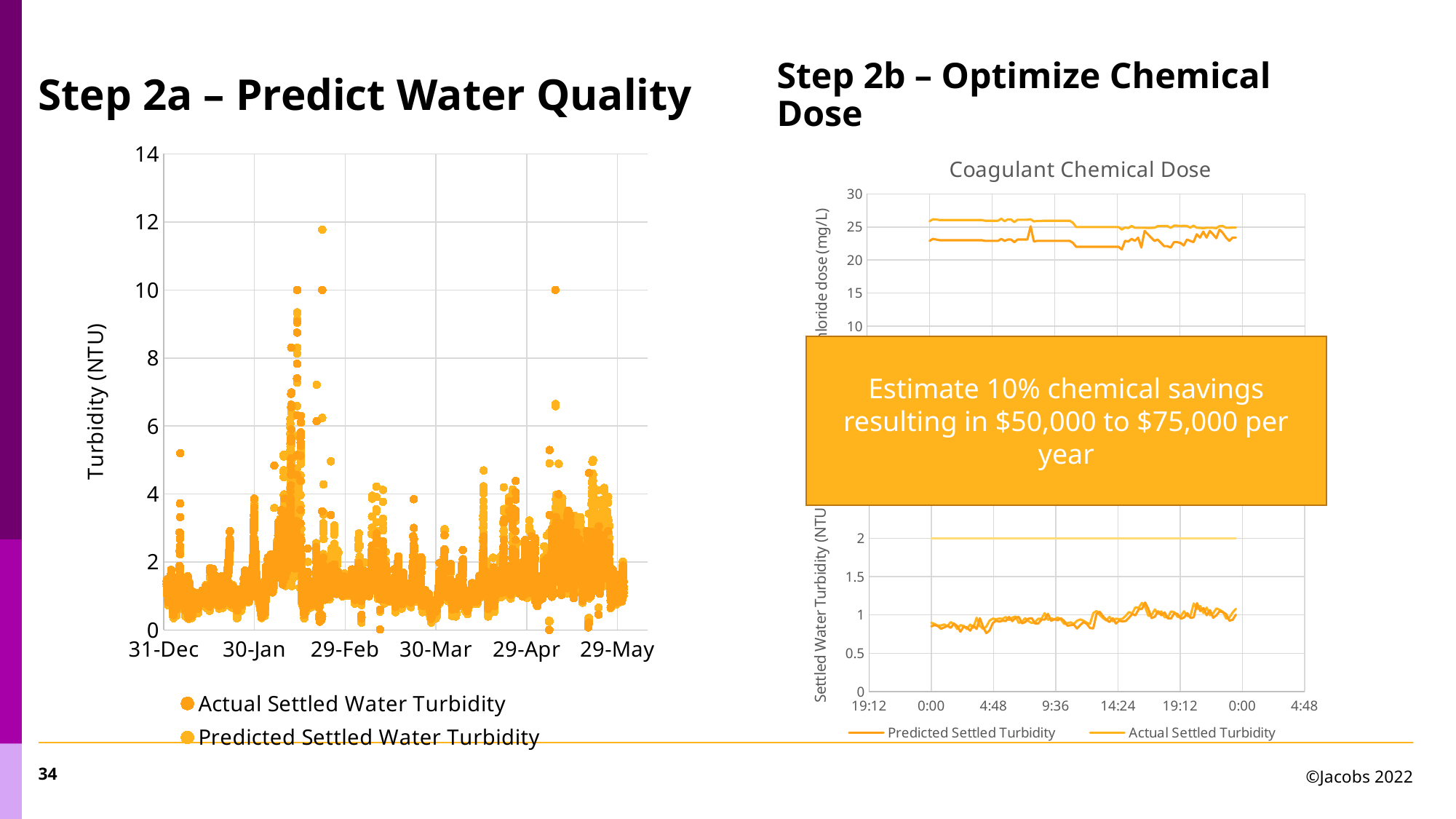
What is the first date label on the x-axis of the left turbidity chart? 31-Dec What kind of chart is the top-right 'Coagulant Chemical Dose' chart? line chart How many series does the legend of the bottom-right settled water turbidity chart list? 2 What is the title of the top-right chart? Coagulant Chemical Dose In the bottom-right settled water turbidity chart, are the Predicted Settled Turbidity values greater or less than 1.5? less What kind of chart is the left chart titled under 'Step 2a – Predict Water Quality'? scatter chart What is the highest value shown on the y-axis of the left turbidity chart? 14 How many series does the legend of the left turbidity chart list? 2 In the 'Coagulant Chemical Dose' chart, are the plotted dose values greater or less than 20? greater In the left turbidity chart, is the highest plotted turbidity value greater or less than 10? greater What is the y-axis label of the left turbidity chart? Turbidity (NTU) What are the two series named in the legend of the left turbidity chart? Actual Settled Water Turbidity and Predicted Settled Water Turbidity